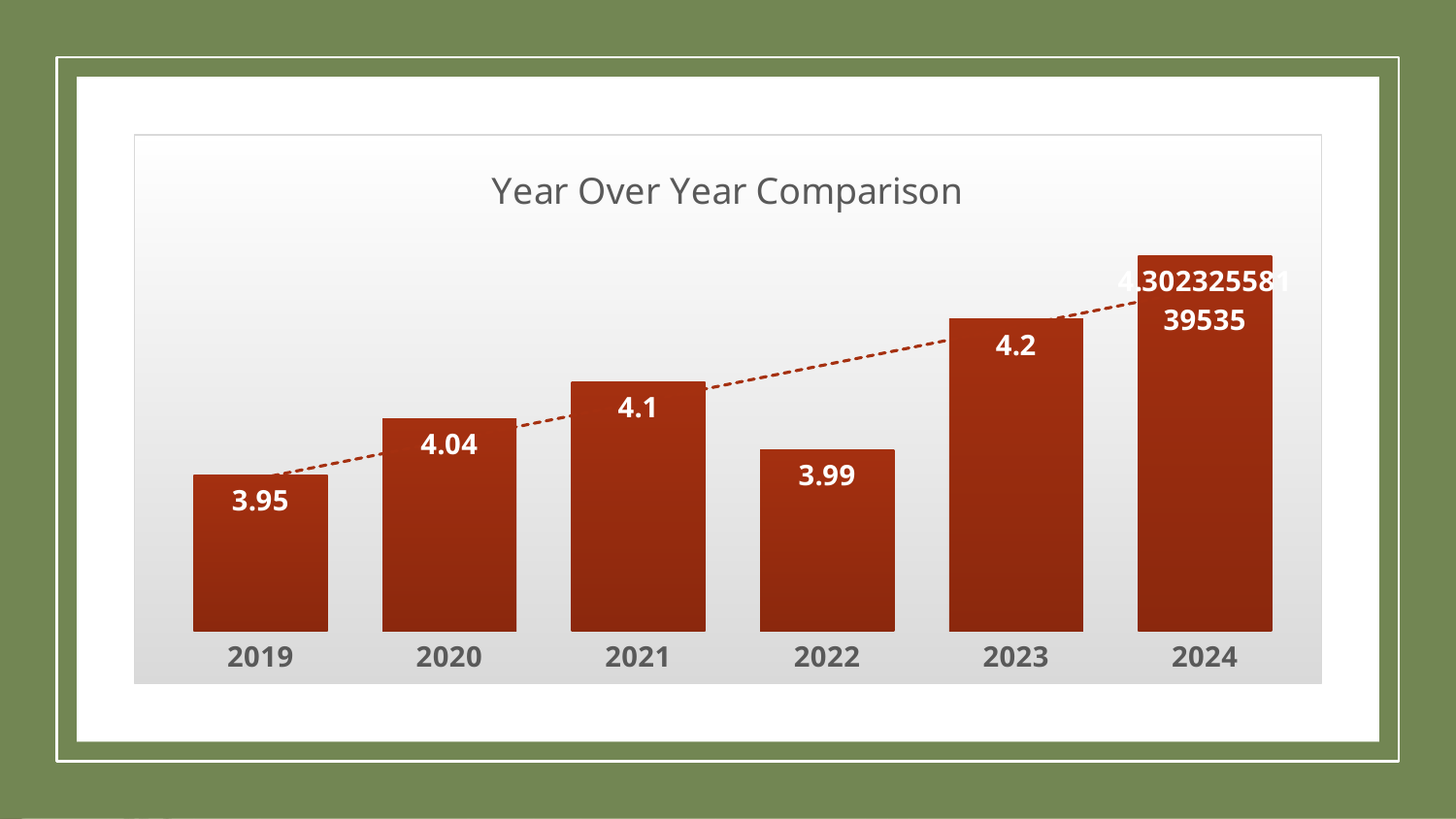
Which year has the larger value, 2021 or 2022? 2021 What kind of chart is this? Bar chart How many years are shown on the chart? 6 Which year has the highest value? 2024 What is the value for 2021? 4.1 What is the value for 2023? 4.2 What is the title of the chart? Year Over Year Comparison Which year has the lowest value? 2019 What is the difference between the values for 2023 and 2019? 0.25 What is the value for 2020? 4.04 What is the value for 2019? 3.95 What is the value for 2022? 3.99